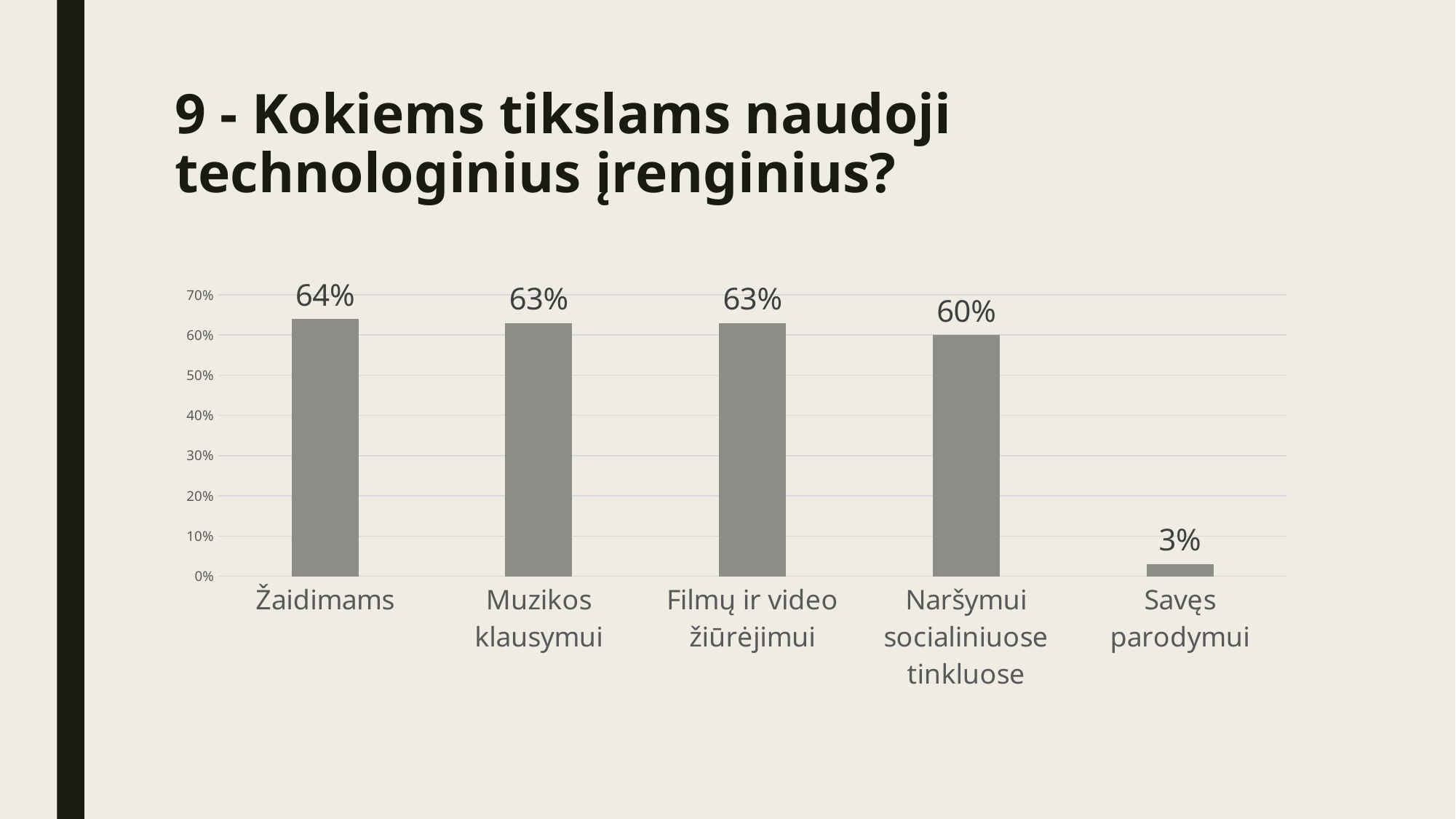
What is the value for Savęs parodymui? 3% Which is larger, the value for Žaidimams or the value for Naršymui socialiniuose tinkluose? Žaidimams How many categories are shown in the chart? 5 Is the value for Naršymui socialiniuose tinkluose greater or less than 50%? greater Which category has the lowest value? Savęs parodymui What is the title of the slide? 9 - Kokiems tikslams naudoji technologinius įrenginius? What is the value for Muzikos klausymui? 63% What is the difference between the values for Žaidimams and Savęs parodymui? 61% What is the difference between the values for Filmų ir video žiūrėjimui and Naršymui socialiniuose tinkluose? 3% What is the value for Žaidimams? 64% What kind of chart is shown on the slide? bar chart What is the value for Naršymui socialiniuose tinkluose? 60%